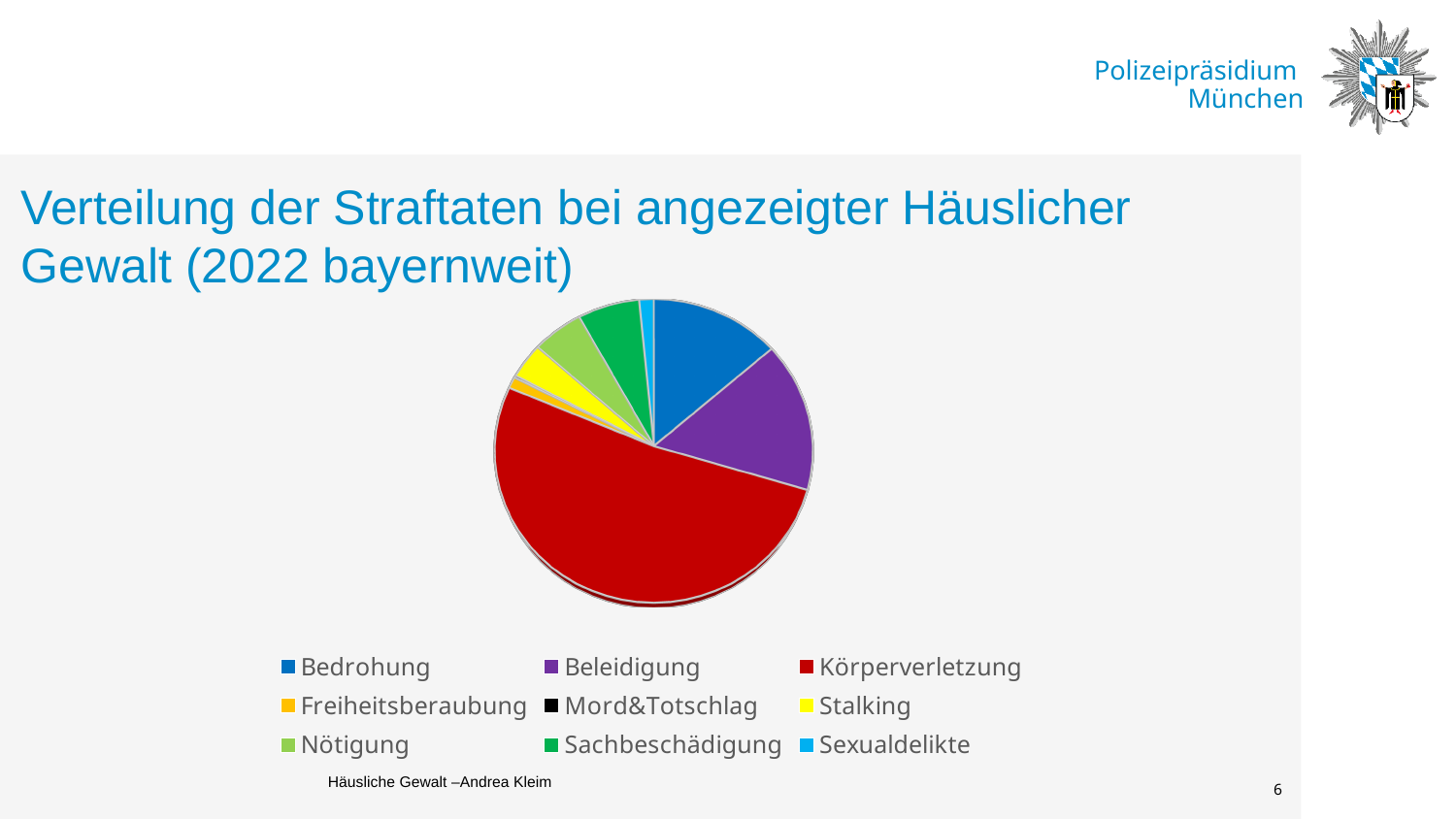
Which colour represents Körperverletzung in the pie chart? red What kind of chart is shown on the slide? pie chart What is the title of the chart on the slide? Verteilung der Straftaten bei angezeigter Häuslicher Gewalt (2022 bayernweit) Which slice is larger, Bedrohung or Freiheitsberaubung? Bedrohung Which slice is larger, Beleidigung or Sexualdelikte? Beleidigung How many categories does the pie chart's legend list? 9 Which slice is larger, Körperverletzung or Bedrohung? Körperverletzung Which category has the largest slice in the pie chart? Körperverletzung